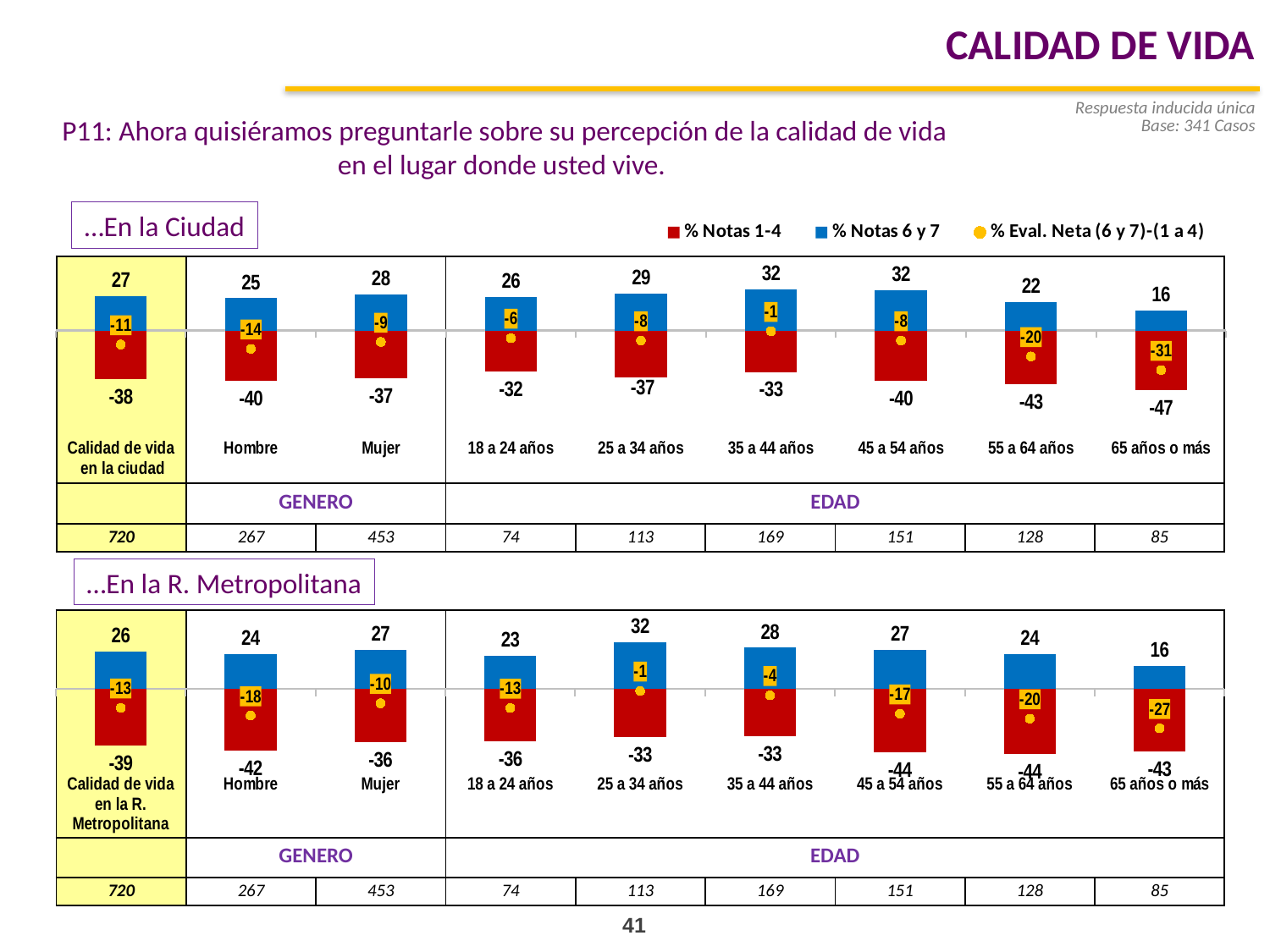
In the '...En la R. Metropolitana' chart, what is the % Eval. Neta value for Hombre? -18 In the '...En la Ciudad' chart, which age group has the lowest % Notas 6 y 7 value? 65 años o más How many series does the legend list for the charts on this slide? 3 In the '...En la Ciudad' chart, what is the % Eval. Neta value for 65 años o más? -31 In the '...En la Ciudad' chart, what is the difference between the % Notas 6 y 7 values for Mujer and Hombre? 3 In the '...En la R. Metropolitana' chart, what is the % Notas 1-4 value for 45 a 54 años? -44 In the '...En la R. Metropolitana' chart, what is the % Notas 6 y 7 value for 25 a 34 años? 32 In the '...En la Ciudad' chart, what is the % Notas 6 y 7 value for Mujer? 28 In the '...En la R. Metropolitana' chart, which age group has the highest % Notas 6 y 7 value? 25 a 34 años In the '...En la R. Metropolitana' chart, is the % Notas 6 y 7 value for Hombre or Mujer larger? Mujer What kind of chart is the '...En la Ciudad' chart? Bar chart In the '...En la Ciudad' chart, what is the % Notas 1-4 value for Hombre? -40